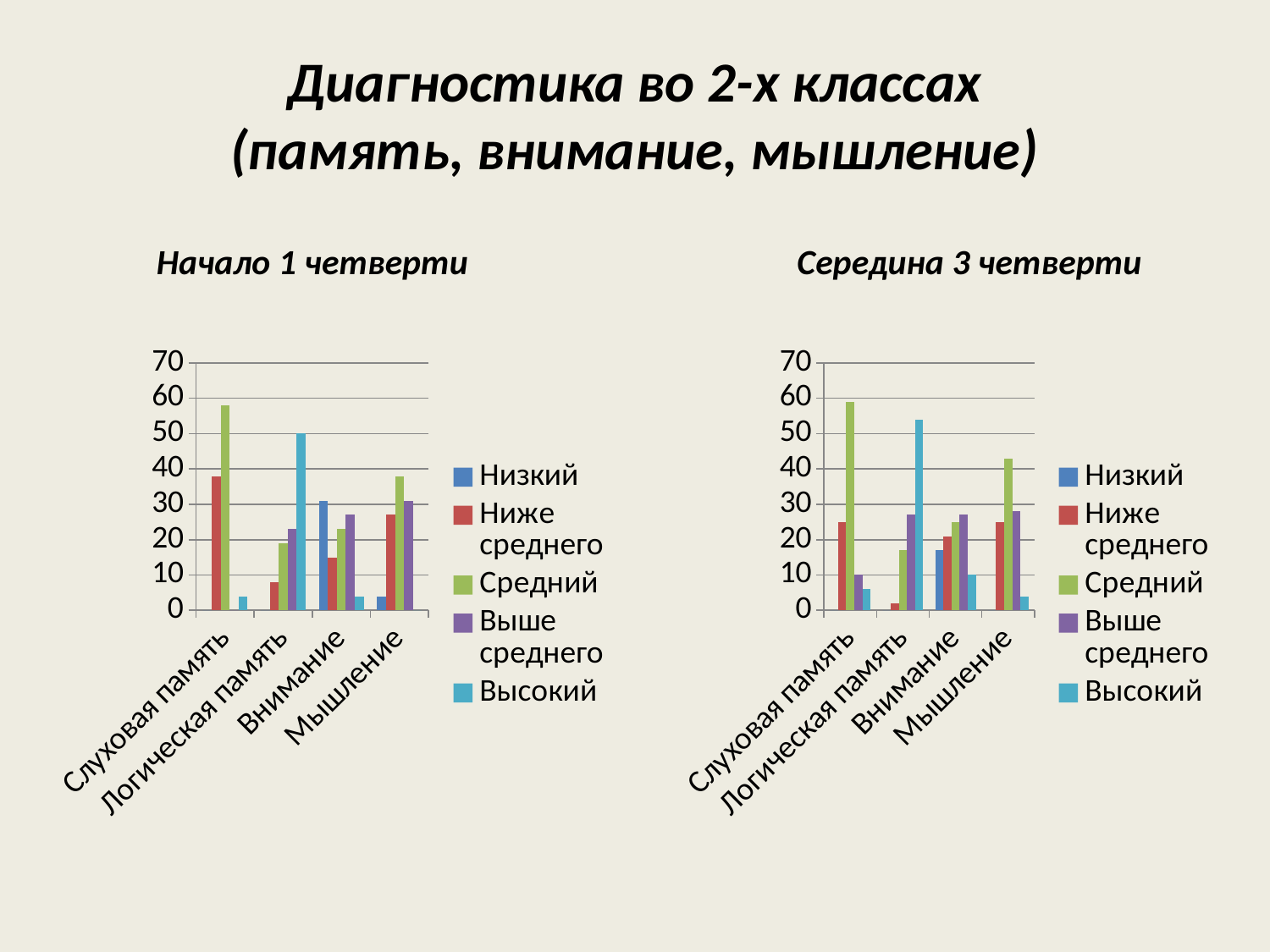
In the "Середина 3 четверти" chart, is the value of Высокий for Логическая память greater or less than 50? greater In the "Середина 3 четверти" chart, which is larger for Мышление: Средний or Ниже среднего? Средний In the "Начало 1 четверти" chart, is the value of Высокий for Логическая память greater or less than 40? greater In the "Начало 1 четверти" chart, which series has the highest value for Внимание? Низкий In the "Начало 1 четверти" chart, which series has the highest value for Мышление? Средний How many categories are shown on the x axis of the "Середина 3 четверти" chart? 4 In the "Середина 3 четверти" chart, is the value of Низкий for Внимание greater or less than 20? less What kind of chart is the "Начало 1 четверти" chart? bar chart In the "Середина 3 четверти" chart, which series has the highest value for Слуховая память? Средний How many series does the legend of the "Начало 1 четверти" chart list? 5 What is the title of the chart on the right side of the slide? Середина 3 четверти